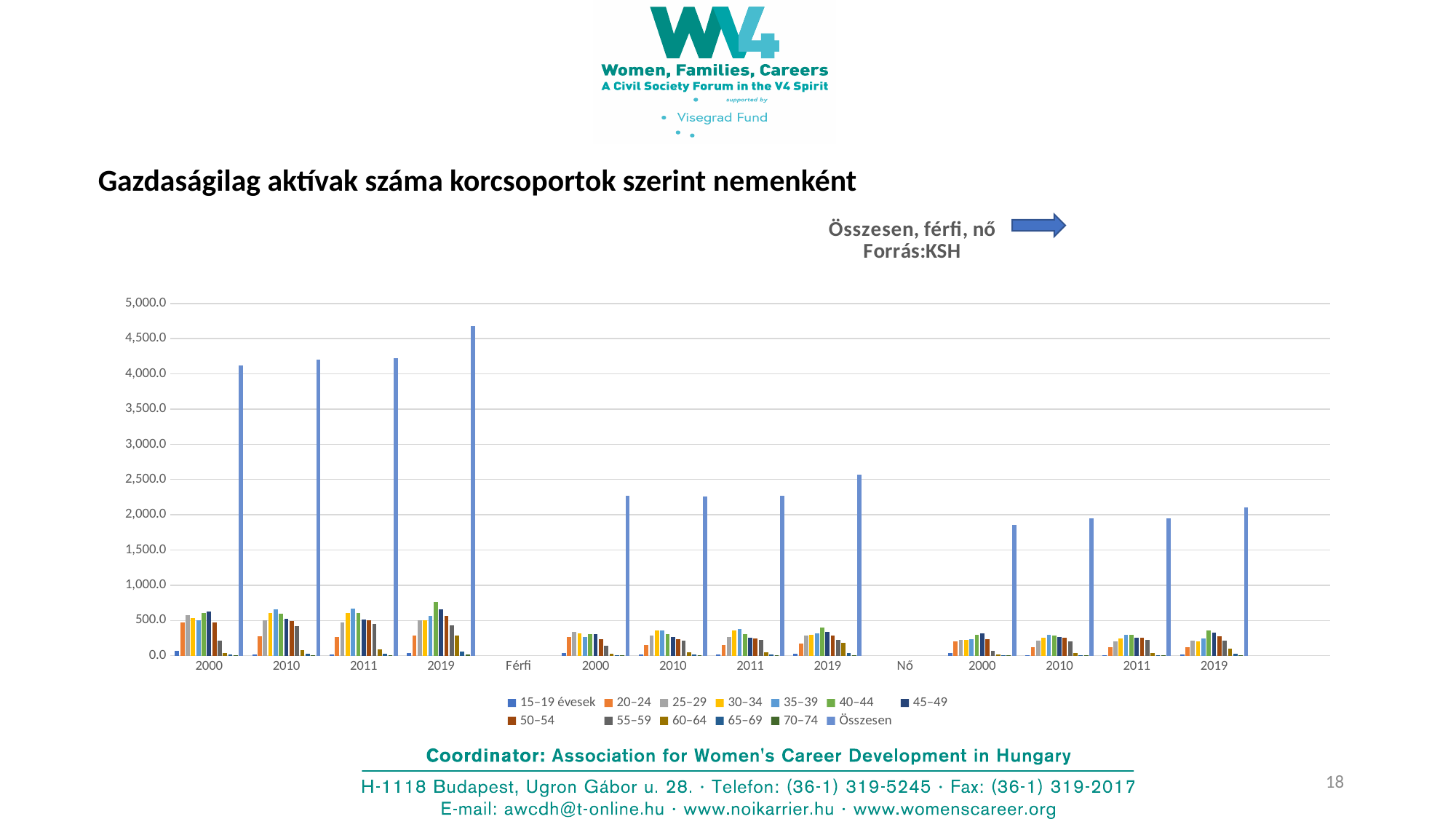
Which is larger, the Összesen bar for 2019 in the Férfi group or the Összesen bar for 2019 in the Nő group? Férfi 2019 What kind of chart is shown on the slide? bar chart Is the Összesen value for 2000 in the leftmost group greater or less than 3,500? greater Is the Összesen value for 2000 in the Nő group greater or less than 2,000? less How many series does the legend list? 13 In the Nő group, which year has the lowest Összesen bar? 2000 What is the last entry in the legend? Összesen What is the title of the chart? Összesen, férfi, nő Forrás:KSH Does the Összesen bar rise or fall from 2000 to 2019 in the leftmost group? rise In the leftmost group of years, which year has the tallest Összesen bar? 2019 Is the Összesen value for 2019 in the Férfi group greater or less than 2,000? greater